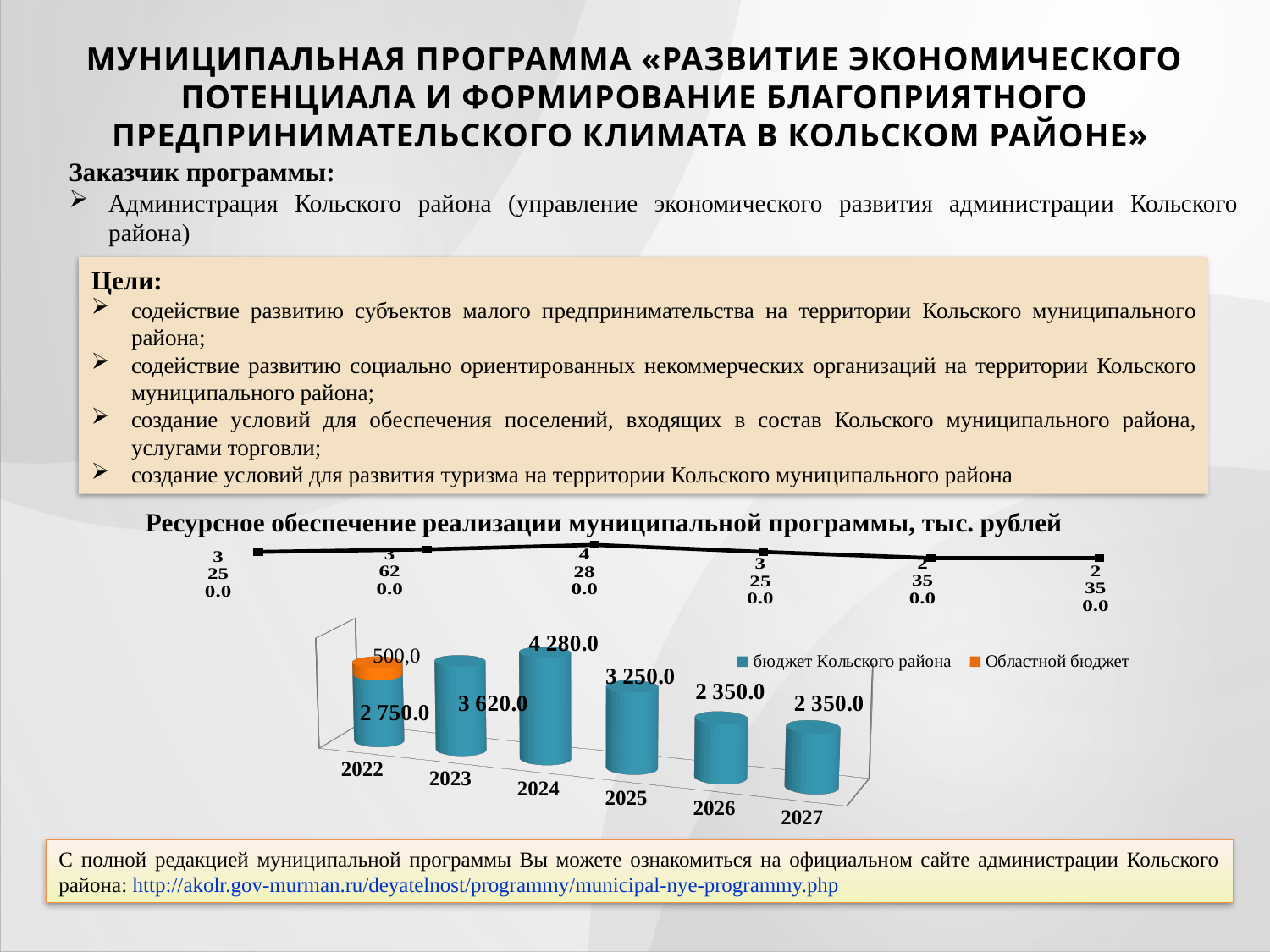
Which is larger, the бюджет Кольского района value for 2023 or for 2025? 2023 What kind of chart is shown on the slide? bar chart What is the value for бюджет Кольского района in 2027? 2 350.0 What is the value for бюджет Кольского района in 2023? 3 620.0 What is the value for Областной бюджет in 2022? 500,0 What is the value for бюджет Кольского района in 2024? 4 280.0 How many series does the legend list? 2 Do the бюджет Кольского района values rise or fall from 2024 to 2027? fall What is the difference between the бюджет Кольского района values for 2024 and 2025? 1 030.0 What is the total of the stacked bar for 2022? 3 250.0 Which year has the highest value for бюджет Кольского района? 2024 How many years are shown on the x axis of the chart? 6